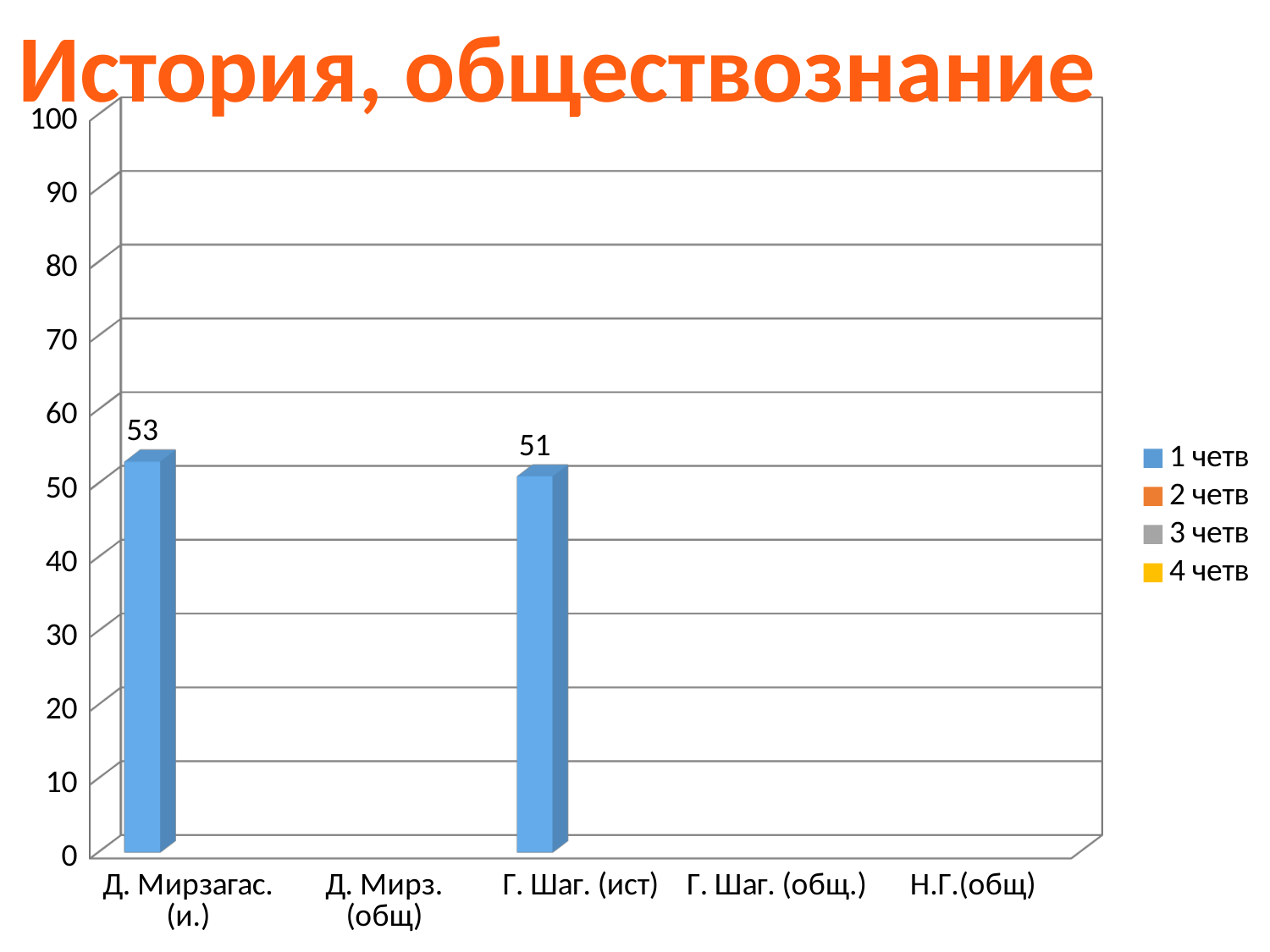
Is the value for Г. Шаг. (ист) greater or less than 60? less Which is larger, the value for Д. Мирзагас. (и.) or the value for Г. Шаг. (ист)? Д. Мирзагас. (и.) Which series do the plotted bars belong to? 1 четв What is the value for Д. Мирзагас. (и.) in the 1 четв series? 53 How many series does the legend list? 4 Is the value for Д. Мирзагас. (и.) greater or less than 50? greater Which category has the highest plotted value? Д. Мирзагас. (и.) What is the difference between the values for Д. Мирзагас. (и.) and Г. Шаг. (ист)? 2 What kind of chart is shown on the slide? bar chart What is the value for Г. Шаг. (ист) in the 1 четв series? 51 What is the title of the slide? История, обществознание How many categories are shown on the x axis? 5